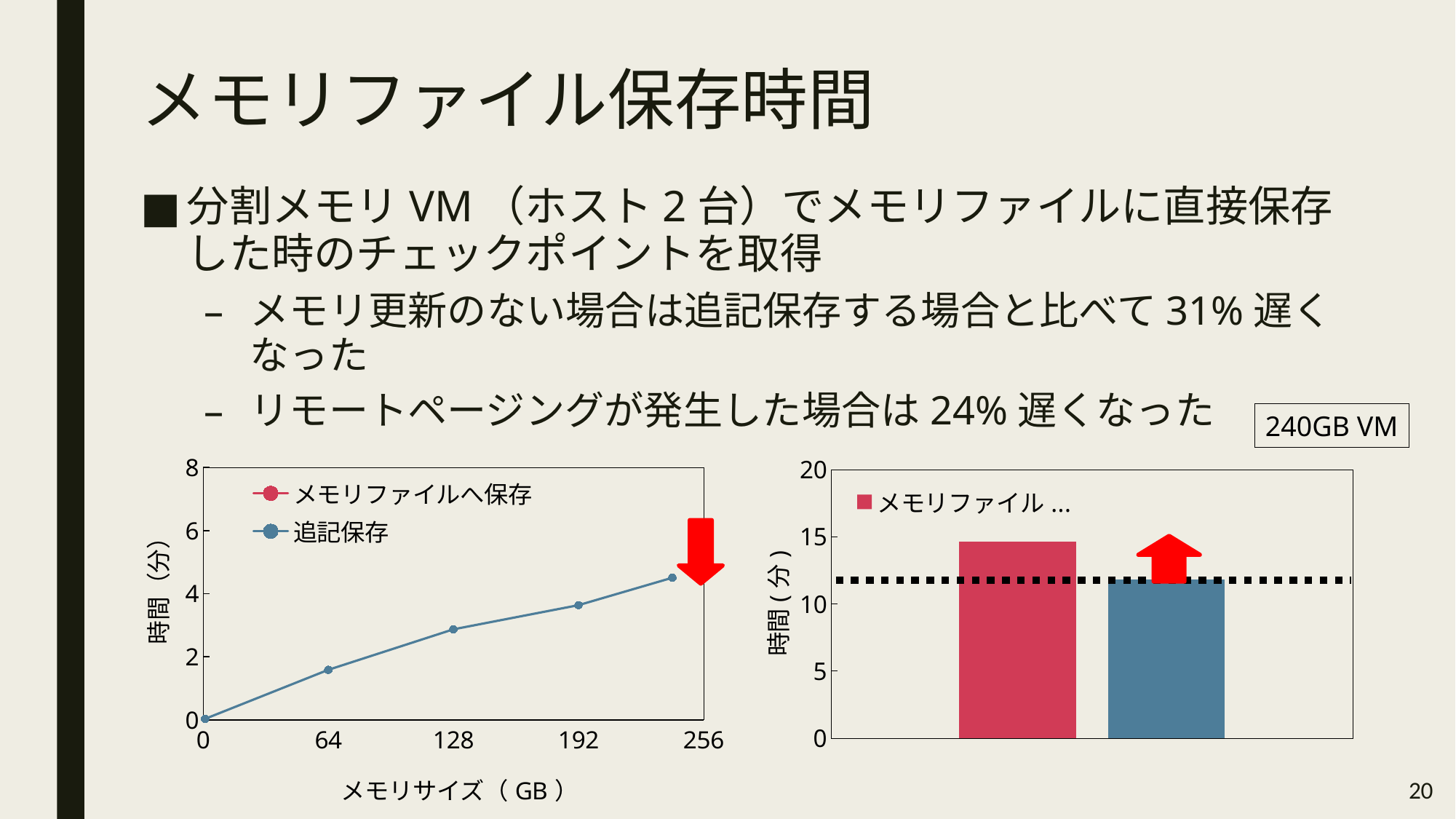
In the right chart, how many bars are plotted? 2 In the left chart, what is the label of the x axis? メモリサイズ（GB） What kind of chart is the right chart on the slide? bar chart In the right chart, which bar is taller, the red bar or the blue bar? the red bar In the left chart, what is the label of the y axis? 時間（分） What kind of chart is the left chart on the slide? line chart In the right chart, is the red bar greater or less than 10? greater In the left chart, does the 追記保存 line rise or fall as memory size increases? rise In the left chart, is the value for 追記保存 at 192 GB greater or less than 2? greater In the left chart, is the value for 追記保存 at 128 GB greater or less than 4? less In the left chart, how many series does the legend list? 2